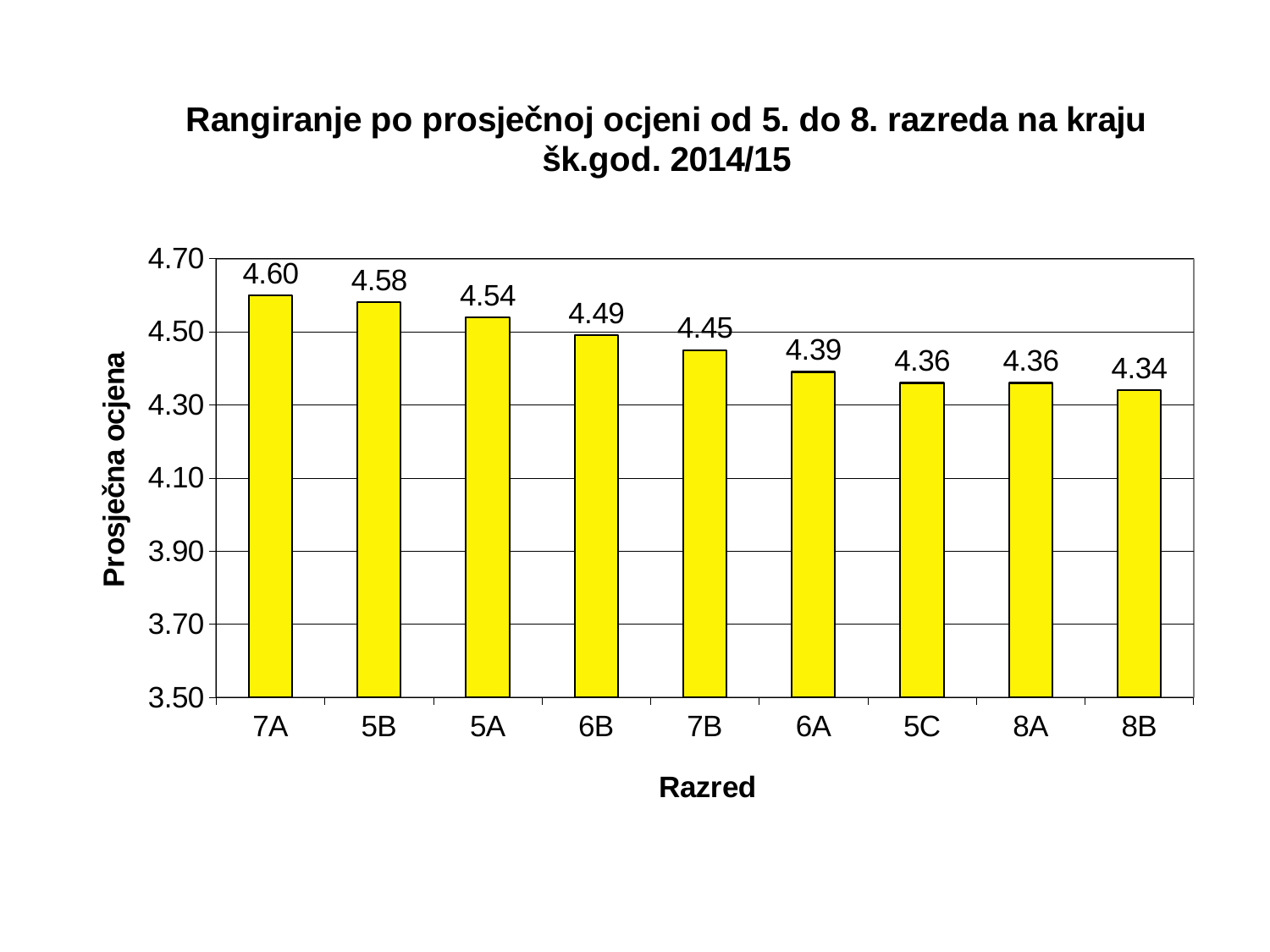
Which class has a higher average grade, 5A or 6A? 5A Do the values rise or fall from left to right along the x axis? fall What is the difference between the average grades of 5B and 7B? 0.13 Which class has the lowest average grade? 8B What is the average grade for class 8B? 4.34 What kind of chart is shown on the slide? bar chart How many classes are shown on the x axis? 9 Which class has the highest average grade? 7A What is the average grade (prosječna ocjena) for class 7A? 4.60 What is the average grade for class 6B? 4.49 Is the value for 6A greater or less than 4.30? greater What is the difference between the average grades of 7A and 8B? 0.26